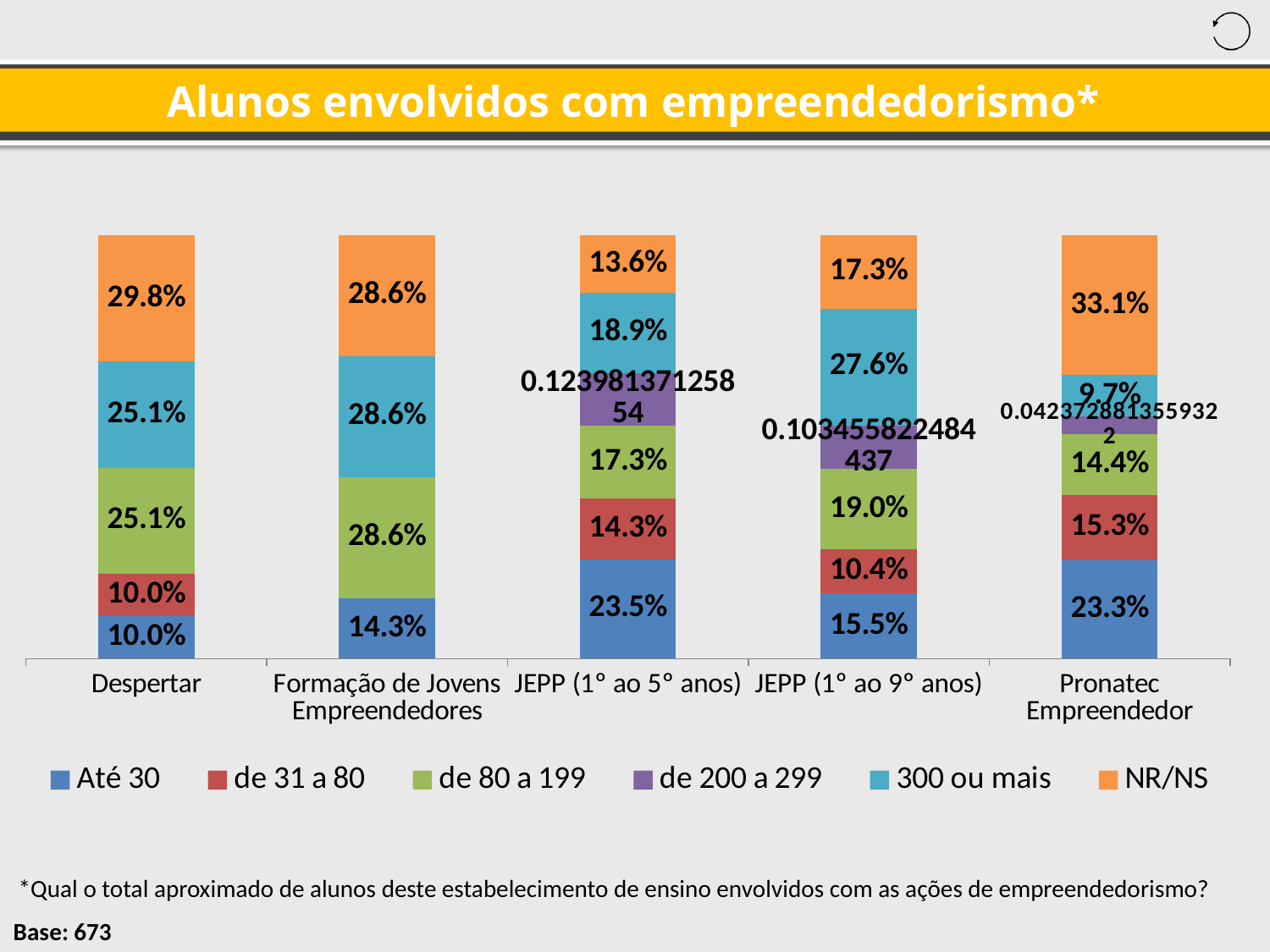
What is the '300 ou mais' value for JEPP (1° ao 9° anos)? 27.6% Which category has the highest NR/NS share? Pronatec Empreendedor How many series does the legend list? 6 Which category has the lowest 'Até 30' share? Despertar Which has a larger '300 ou mais' share: Despertar or JEPP (1° ao 9° anos)? JEPP (1° ao 9° anos) How many categories are shown on the x axis? 5 What is the value of the 'Até 30' segment for Formação de Jovens Empreendedores? 14.3% What is the NR/NS share for Despertar? 29.8% What is the 'Até 30' value for JEPP (1° ao 5° anos)? 23.5% What is the NR/NS share for Pronatec Empreendedor? 33.1% What kind of chart is shown on the slide? Stacked bar chart What is the difference between the NR/NS share for Pronatec Empreendedor and for Despertar? 3.3%